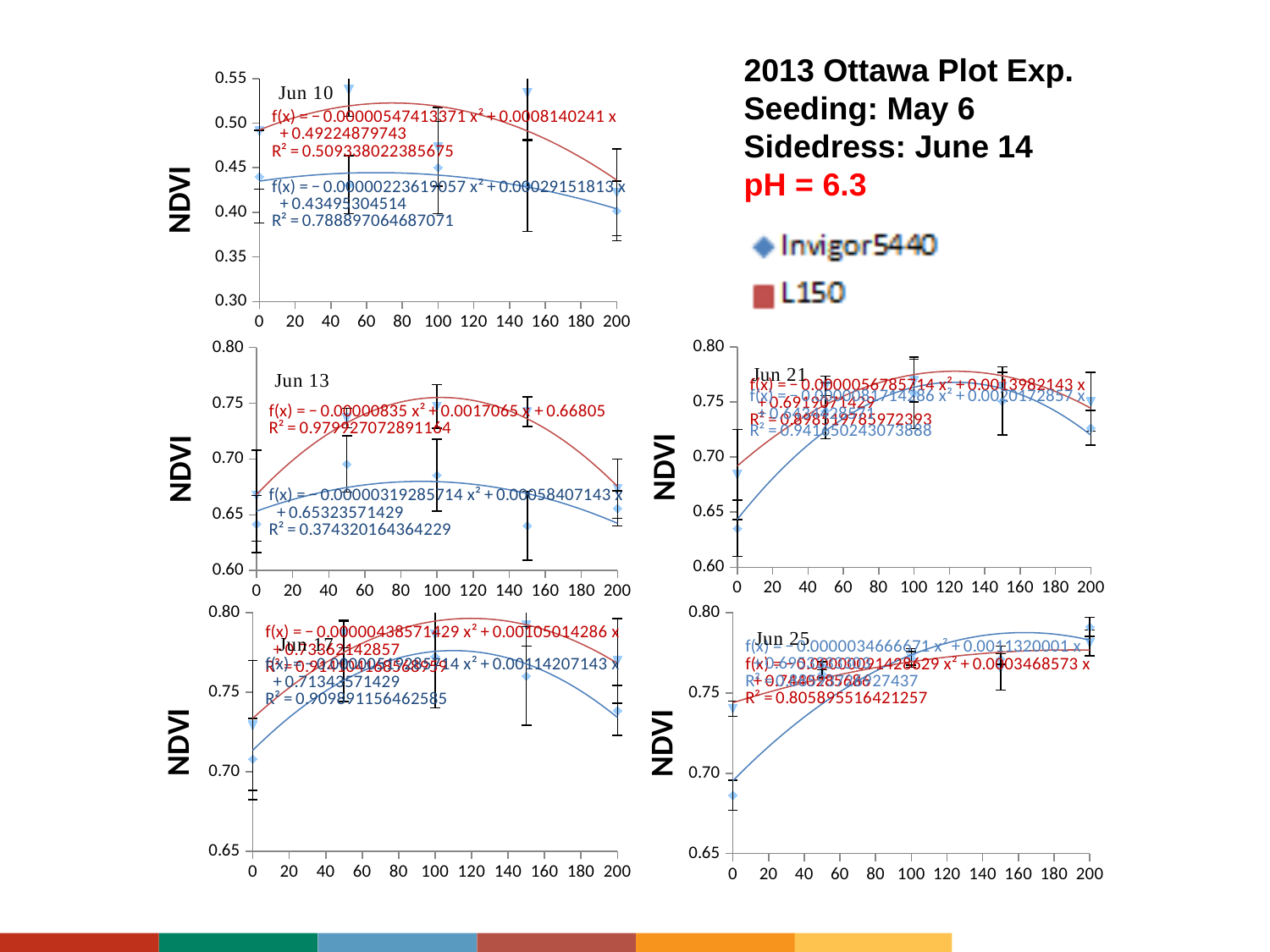
What is the y-axis label on the Jun 13 chart? NDVI In the Jun 21 chart, does the Invigor5440 trendline rise or fall from x = 0 to x = 100? rise In the Jun 10 chart, what R² value is printed for the Invigor5440 (blue) trendline? 0.788897064687071 How many charts are shown on the slide? 5 In the Jun 25 chart, is the Invigor5440 value at x = 0 greater or less than 0.70? less In the Jun 10 chart, is the Invigor5440 value at x = 200 greater or less than 0.45? less In the Jun 10 chart, how many data points are plotted for the Invigor5440 series? 5 How many series does the legend list? 2 What kind of chart is the Jun 10 chart? Scatter chart with trendlines In the Jun 10 chart, which series has the higher trendline, L150 or Invigor5440? L150 In the Jun 21 chart, is the Invigor5440 value at x = 0 greater or less than 0.65? less